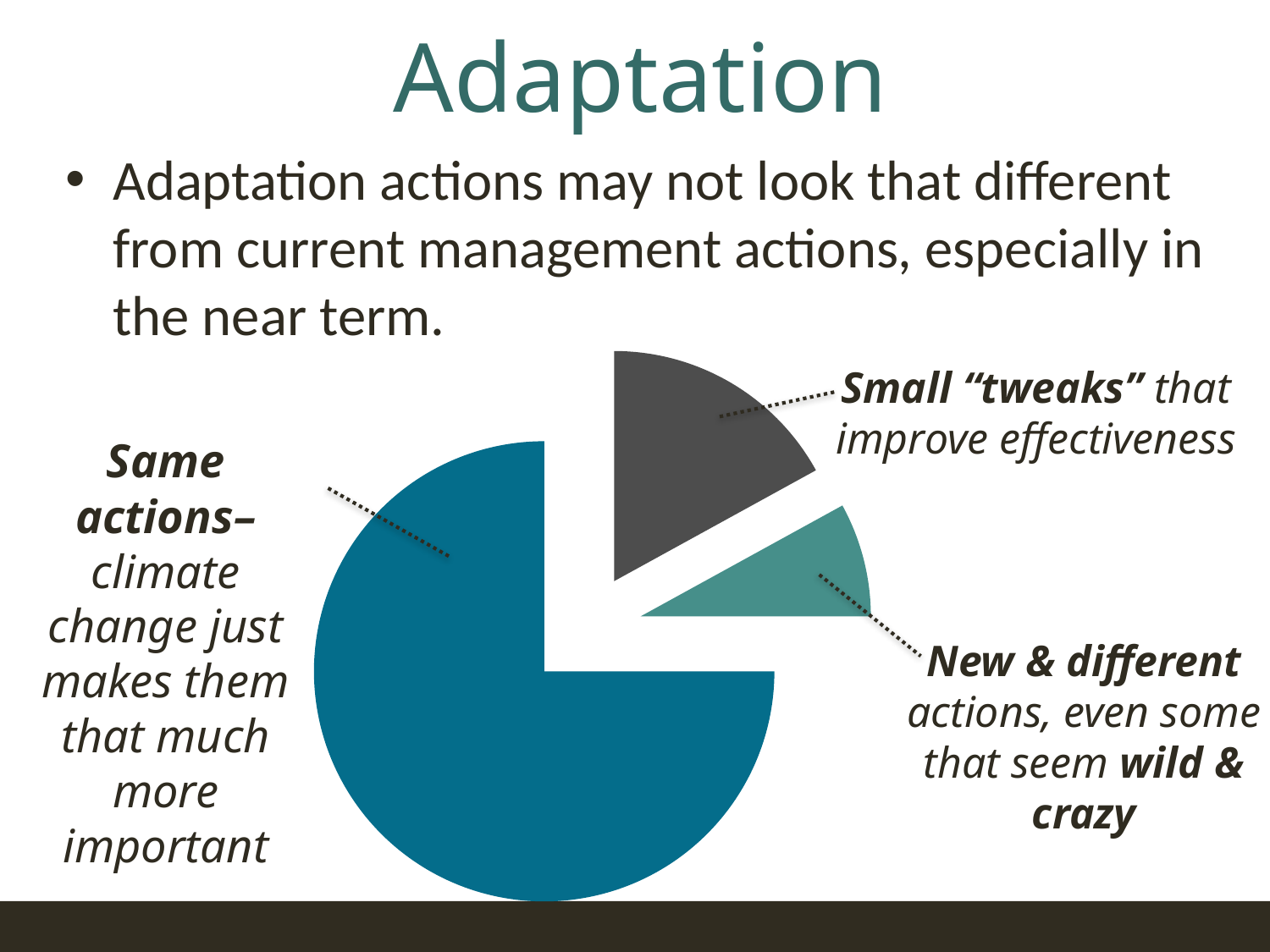
Which slice of the pie chart is the smallest? New & different actions What colour is the "Small tweaks" slice of the pie chart? dark gray How many slices does the pie chart have? 3 Which slice of the pie chart is the largest? Same actions Which slice is larger: "Small tweaks" or "New & different"? Small tweaks Which slice is larger: "Same actions" or "Small tweaks"? Same actions Does the "Same actions" slice take up more or less than half of the pie? more What kind of chart is shown on the slide? pie chart What colour is the "Same actions" slice of the pie chart? blue